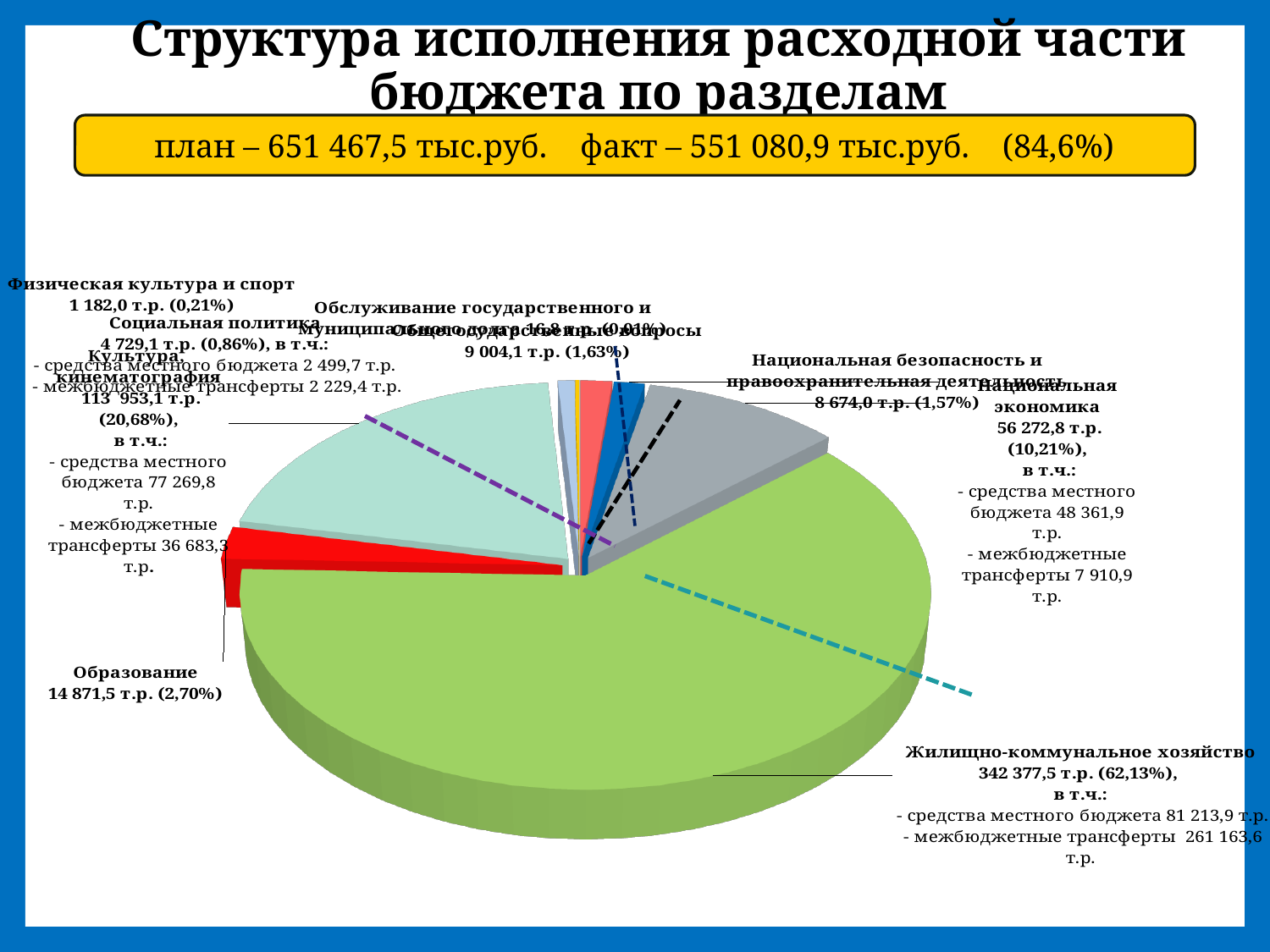
What is the value shown for Жилищно-коммунальное хозяйство? 342 377,5 т.р. What is the value of межбюджетные трансферты within Национальная экономика? 7 910,9 т.р. What kind of chart is shown on the slide? pie chart What share of the pie does Жилищно-коммунальное хозяйство represent? 62,13% What is the title of the chart on the slide? Структура исполнения расходной части бюджета по разделам Which is larger: Общегосударственные вопросы or Национальная безопасность и правоохранительная деятельность? Общегосударственные вопросы What share of the pie does Национальная экономика represent? 10,21% What is the value shown for Образование? 14 871,5 т.р. What share of the pie does Физическая культура и спорт represent? 0,21% What is the value shown for Культура, кинематография? 113 953,1 т.р. Which section has the largest slice of the pie? Жилищно-коммунальное хозяйство What is the difference between the values for Общегосударственные вопросы and Национальная безопасность и правоохранительная деятельность? 330,1 т.р.